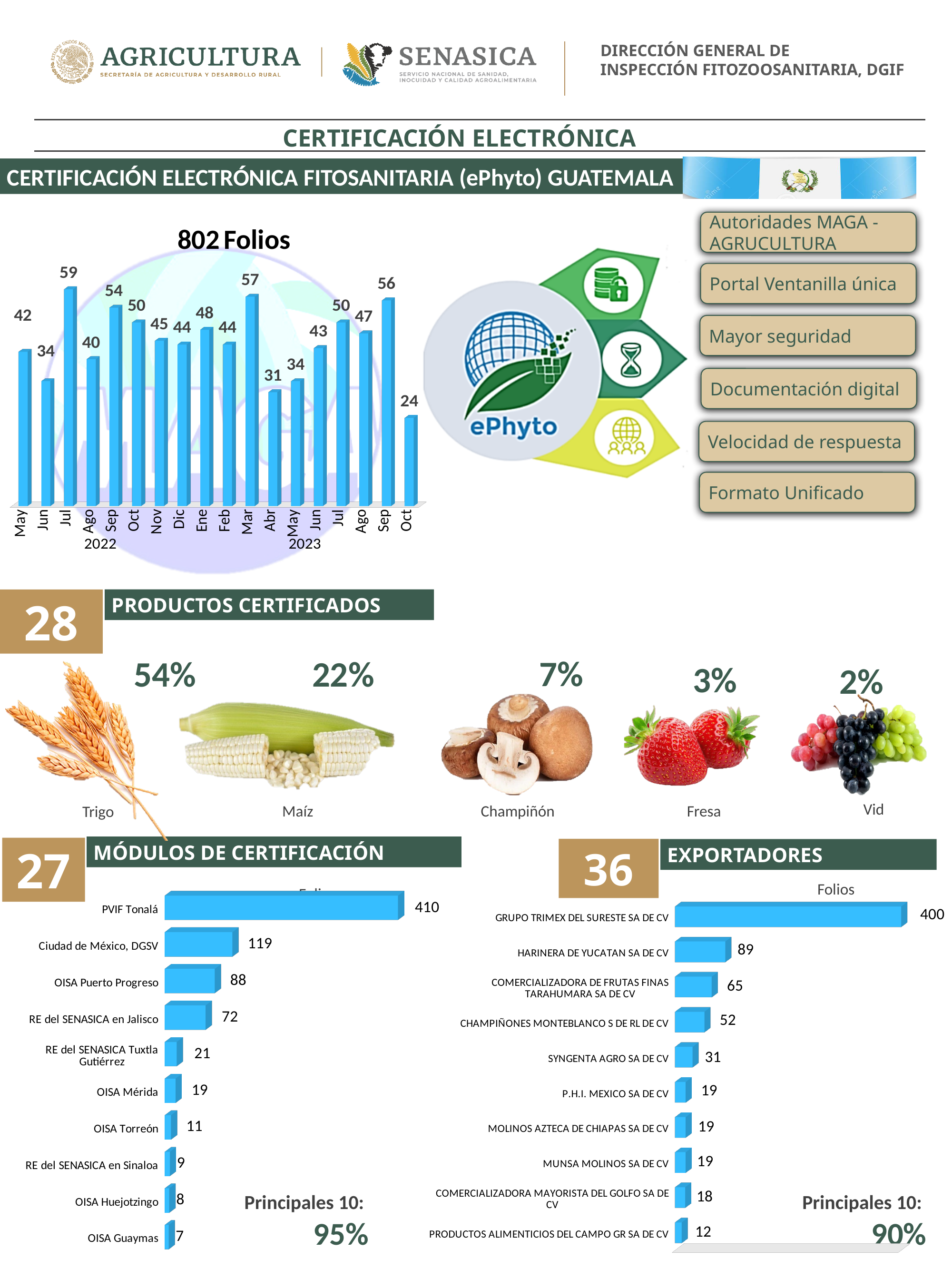
In the '802 Folios' chart, what is the difference between Mar 2023 and Abr 2023? 26 In the 'Módulos de Certificación' chart, what is the difference between PVIF Tonalá and Ciudad de México, DGSV? 291 In the 'Exportadores' chart, which is larger, SYNGENTA AGRO SA DE CV or CHAMPIÑONES MONTEBLANCO S DE RL DE CV? CHAMPIÑONES MONTEBLANCO S DE RL DE CV In the '802 Folios' chart, which month has the lowest value? Oct 2023 In the 'Módulos de Certificación' chart, what is the value for OISA Puerto Progreso? 88 In the 'Exportadores' chart, how many exporters are listed? 10 In the 'Módulos de Certificación' chart, which category has the highest value? PVIF Tonalá In the '802 Folios' chart, what is the value for Jul 2022? 59 In the 'Exportadores' chart, what is the value for HARINERA DE YUCATAN SA DE CV? 89 In the '802 Folios' chart, which is larger, Sep 2022 or Sep 2023? Sep 2023 In the '802 Folios' chart, how many bars are plotted? 18 What type of chart is the 'Módulos de Certificación' chart? Bar chart